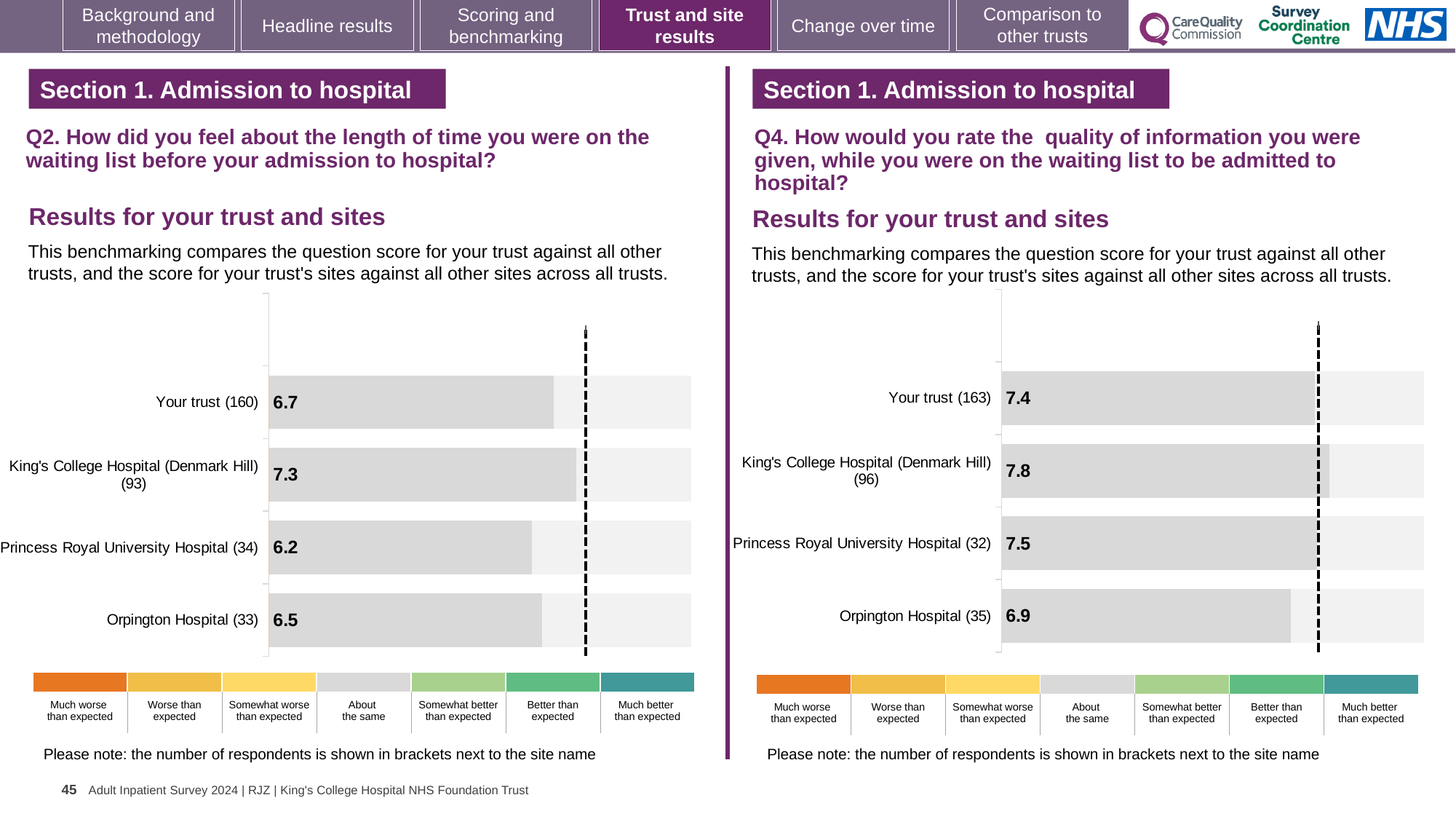
In the Q4 chart on the right, what is the score for Orpington Hospital (35)? 6.9 In the Q2 chart on the left, what is the score for Your trust (160)? 6.7 In the Q4 chart on the right, what is the difference between the scores for Your trust and Orpington Hospital? 0.5 In the Q2 chart on the left, which site or trust has the lowest score? Princess Royal University Hospital (34) In the Q4 chart on the right, which is larger: the score for Your trust or the score for Princess Royal University Hospital? Princess Royal University Hospital How many bars are plotted in the Q2 chart on the left? 4 In the Q2 chart on the left, what is the score for Princess Royal University Hospital (34)? 6.2 In the Q2 chart on the left, which site or trust has the highest score? King's College Hospital (Denmark Hill) (93) In the Q4 chart on the right, what is the score for King's College Hospital (Denmark Hill) (96)? 7.8 In the Q2 chart on the left, what is the difference between the scores for King's College Hospital (Denmark Hill) and Orpington Hospital? 0.8 What type of chart is used for the Q4 results on the right? Bar chart In the Q4 chart on the right, which site or trust has the lowest score? Orpington Hospital (35)